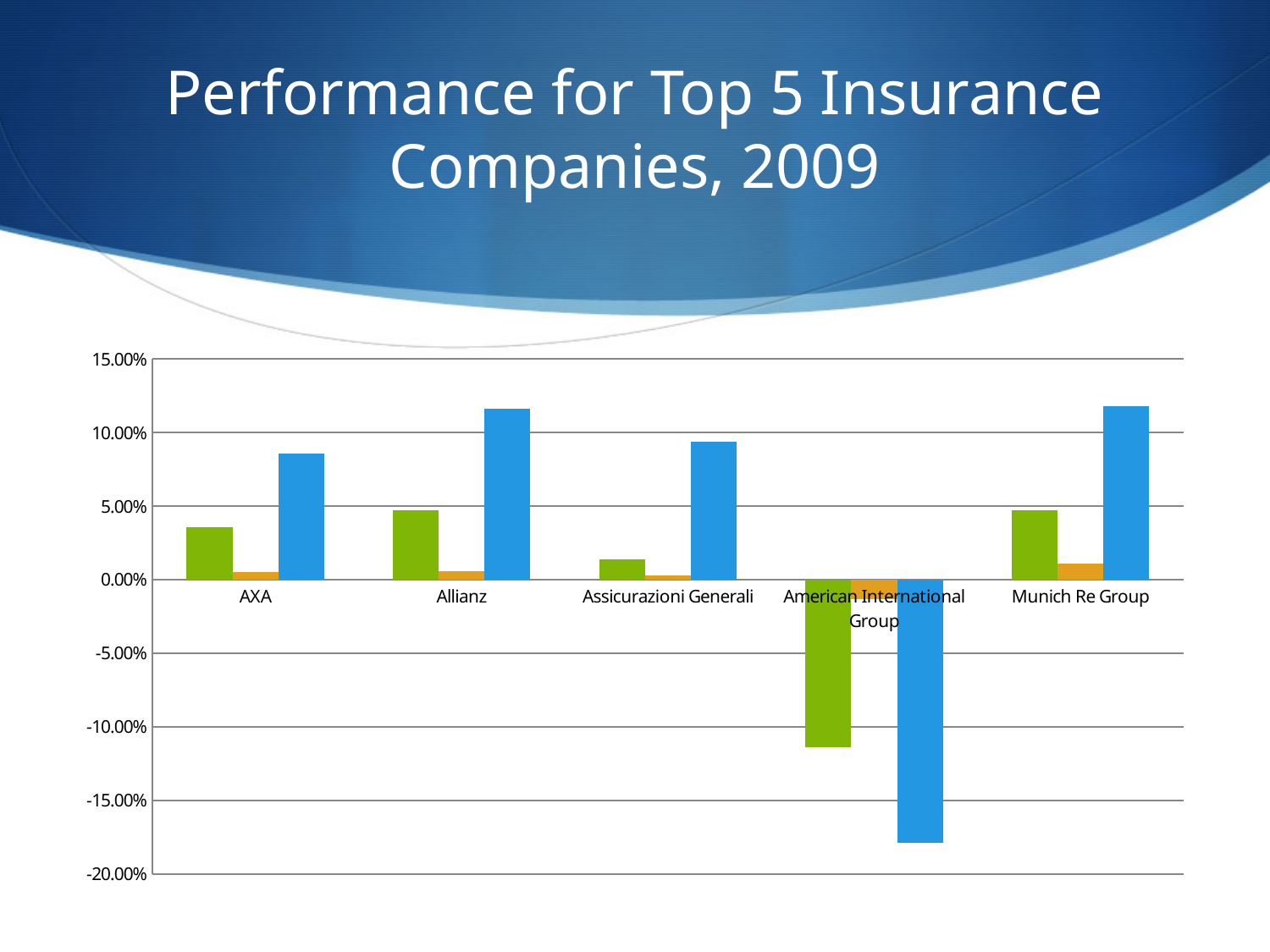
Is the green bar for American International Group greater or less than -10.00%? less Which company has the lowest blue bar? American International Group Is the blue bar for American International Group greater or less than -15.00%? less Which is larger, the green bar for AXA or the green bar for Allianz? Allianz Is the blue bar for Assicurazioni Generali greater or less than 10.00%? less Which company is the only one with bars extending below 0.00%? American International Group What kind of chart is shown on the slide? bar chart What is the title of the slide? Performance for Top 5 Insurance Companies, 2009 How many bars are plotted for each company? 3 How many insurance companies are shown on the x axis? 5